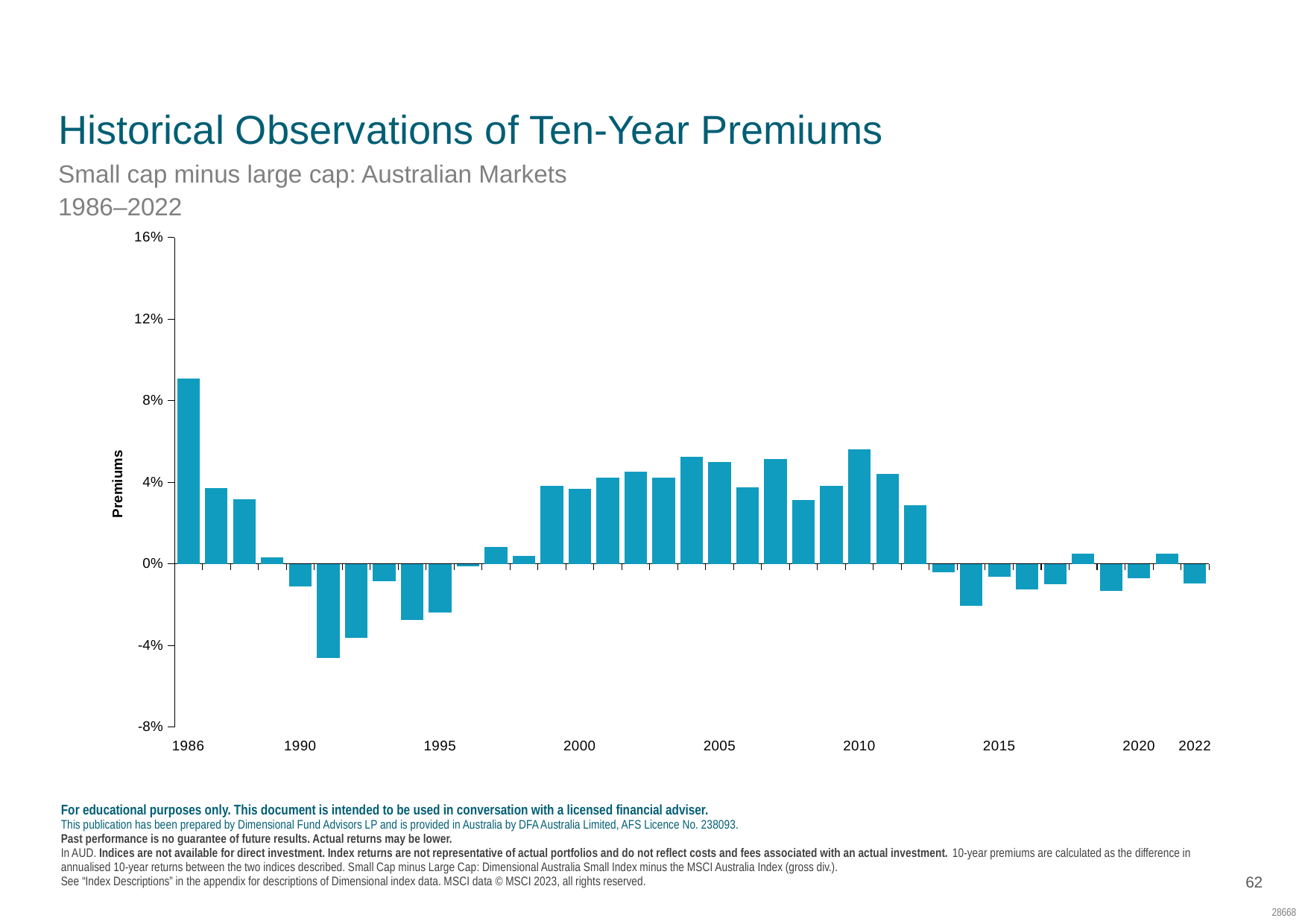
What is the label on the vertical axis of the chart? Premiums Which year has the larger premium, 2005 or 2020? 2005 How many years (bars) are plotted in the chart? 37 Which year has the larger premium, 1986 or 2010? 1986 Is the value for 1986 greater or less than 8%? greater Is the value for 1991 greater or less than -4%? less Do the premiums generally rise or fall from 2010 to 2014? Fall Which year has the lowest ten-year premium in the chart? 1991 Is the value for 2014 greater or less than 0%? less What kind of chart is shown on the slide? Bar chart Which year has the highest ten-year premium in the chart? 1986